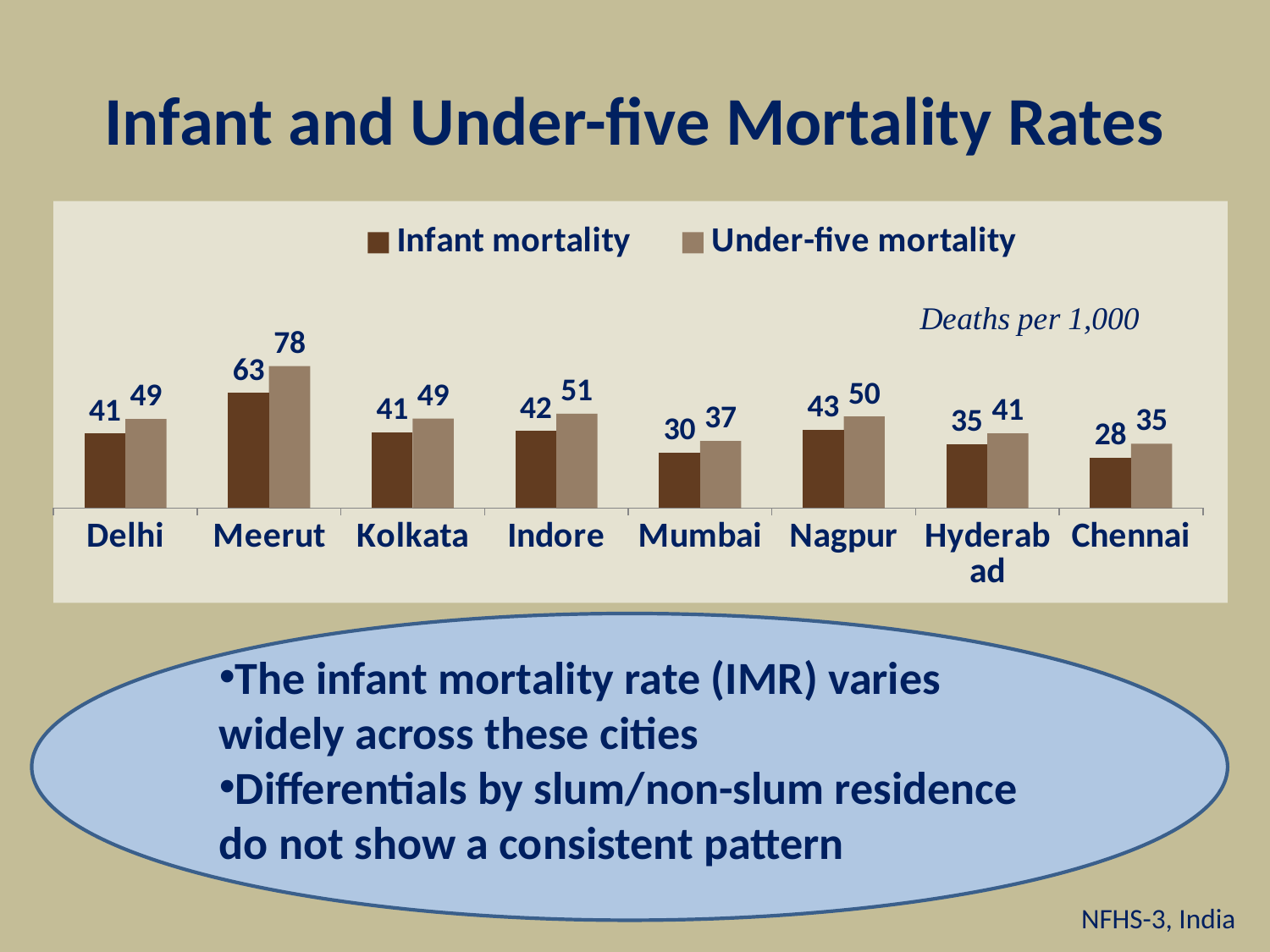
How many series does the legend list? 2 Which city has the highest under-five mortality rate? Meerut Which is larger, the infant mortality rate for Indore or for Mumbai? Indore What kind of chart is shown on the slide? Bar chart What is the infant mortality rate for Meerut? 63 How many cities are shown on the chart? 8 What unit is stated for the values on the chart? Deaths per 1,000 What is the difference between the under-five mortality rate and the infant mortality rate for Meerut? 15 What is the difference between the infant mortality rates of Nagpur and Chennai? 15 What is the under-five mortality rate for Hyderabad? 41 Which city has the lowest infant mortality rate? Chennai What is the under-five mortality rate for Mumbai? 37